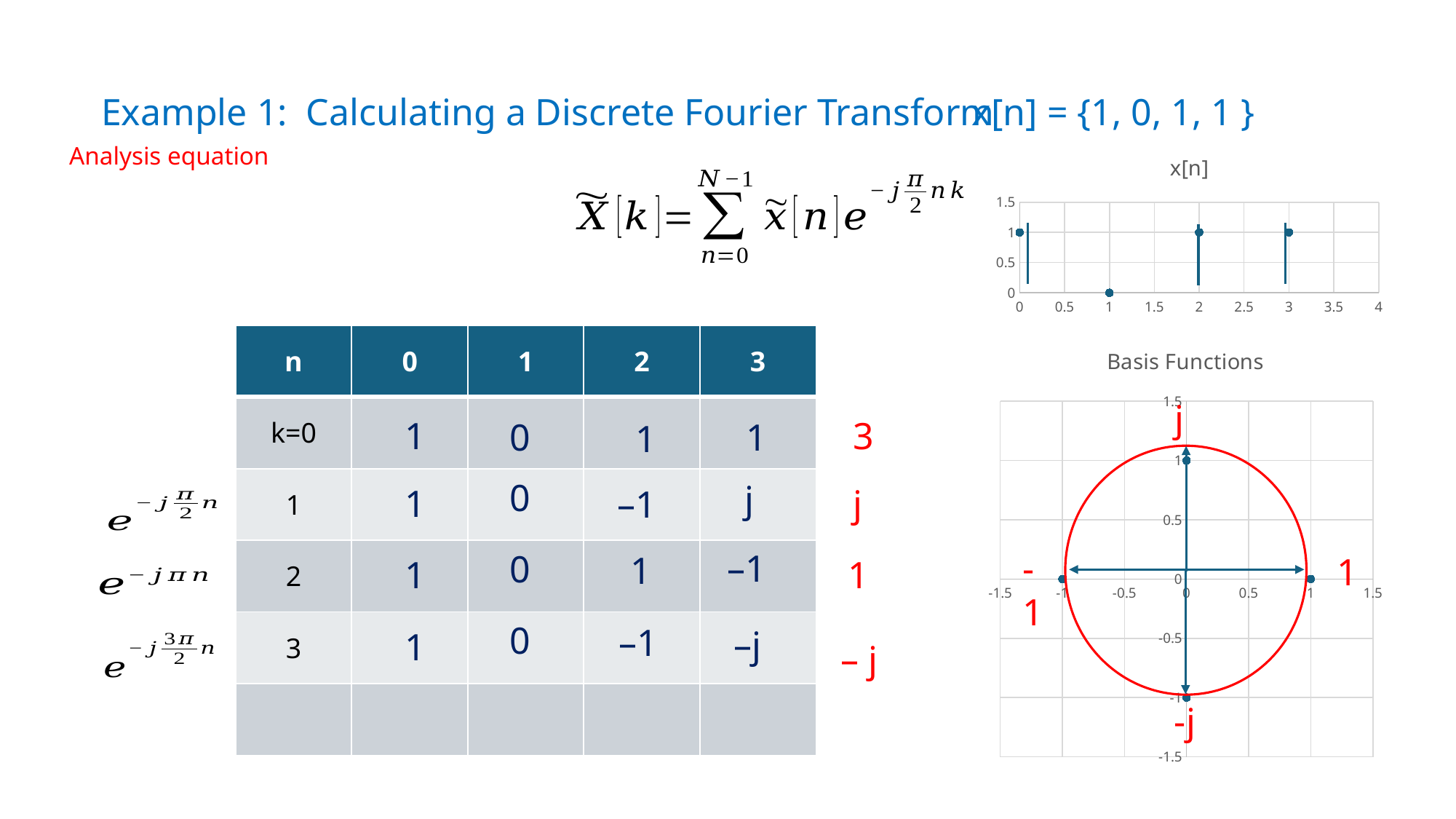
In the x[n] chart, what is the value of x[n] at n = 2? 1 In the x[n] chart, is the value at n = 0 greater or less than 0.5? greater In the x[n] chart, which is larger, the value at n = 1 or the value at n = 3? n = 3 In the Basis Functions chart, what is the x-coordinate of the point labelled 1? 1 In the Basis Functions chart, what is the y-coordinate of the point labelled -j? -1 In the x[n] chart, at which value of n is x[n] lowest? 1 In the x[n] chart, what is the highest tick shown on the vertical axis? 1.5 In the Basis Functions chart, what label is placed at the topmost point of the circle? j In the Basis Functions chart, how many data points are plotted on the circle? 4 In the x[n] chart, what is the difference between the value at n = 0 and the value at n = 1? 1 In the x[n] chart, how many data points are plotted? 4 In the x[n] chart, what is the value of x[n] at n = 1? 0